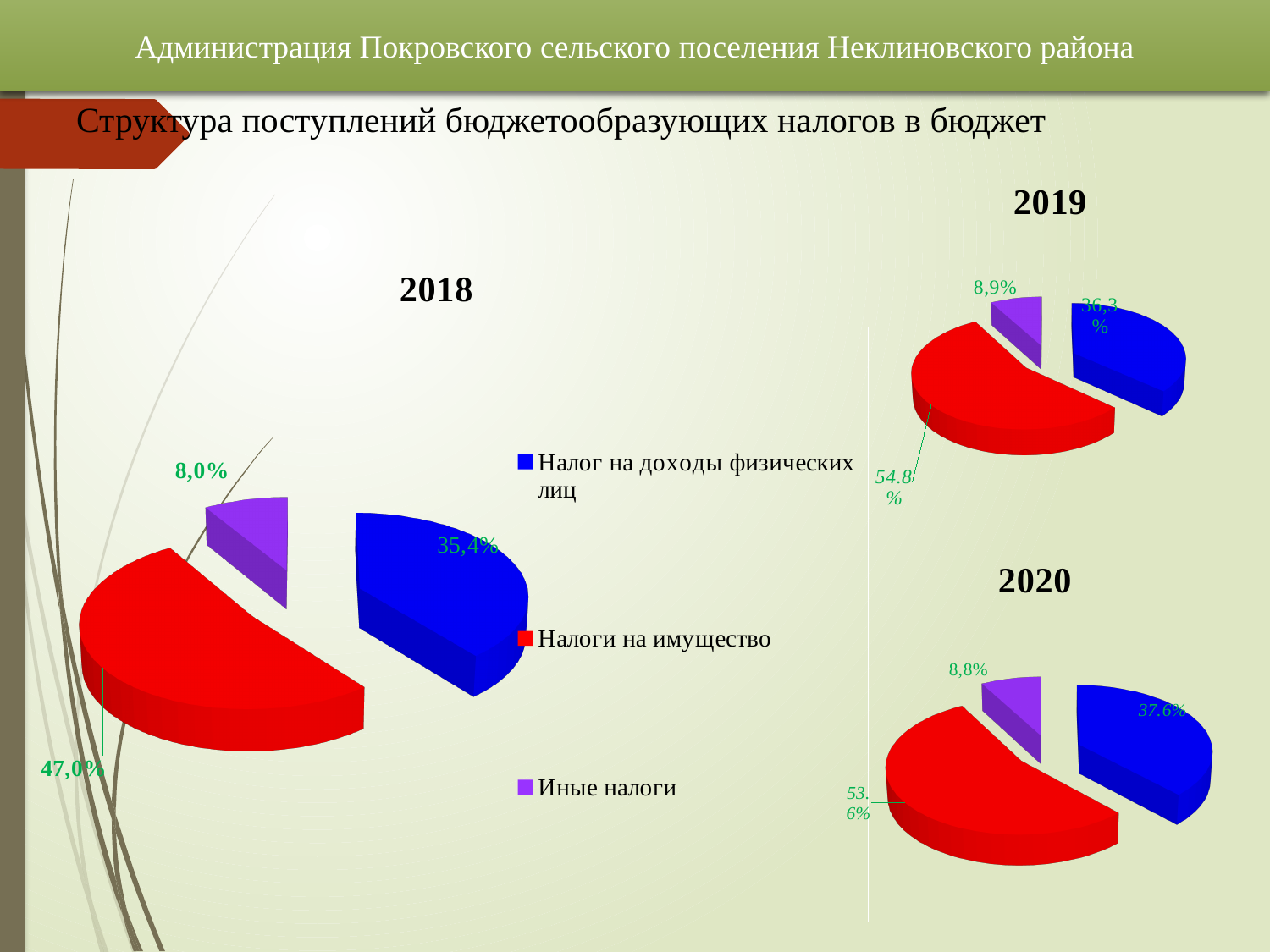
What type of chart is used for the 2018, 2019 and 2020 data on this slide? Pie chart In the 2018 pie chart, what share is shown for Иные налоги? 8,0% How many categories does the legend list? 3 In the 2019 pie chart, what share is shown for Налоги на имущество? 54.8% In the 2018 pie chart, what share is shown for Налоги на имущество? 47,0% In the 2020 pie chart, what share is shown for Налог на доходы физических лиц? 37.6% In the 2020 pie chart, what share is shown for Налоги на имущество? 53.6% In the 2019 pie chart, which category has the smallest share? Иные налоги In the 2020 pie chart, which category has the largest share? Налоги на имущество In the 2018 pie chart, what share is shown for Налог на доходы физических лиц? 35,4% In the 2019 pie chart, what share is shown for Иные налоги? 8,9% In the 2020 pie chart, which is larger: Налог на доходы физических лиц or Иные налоги? Налог на доходы физических лиц